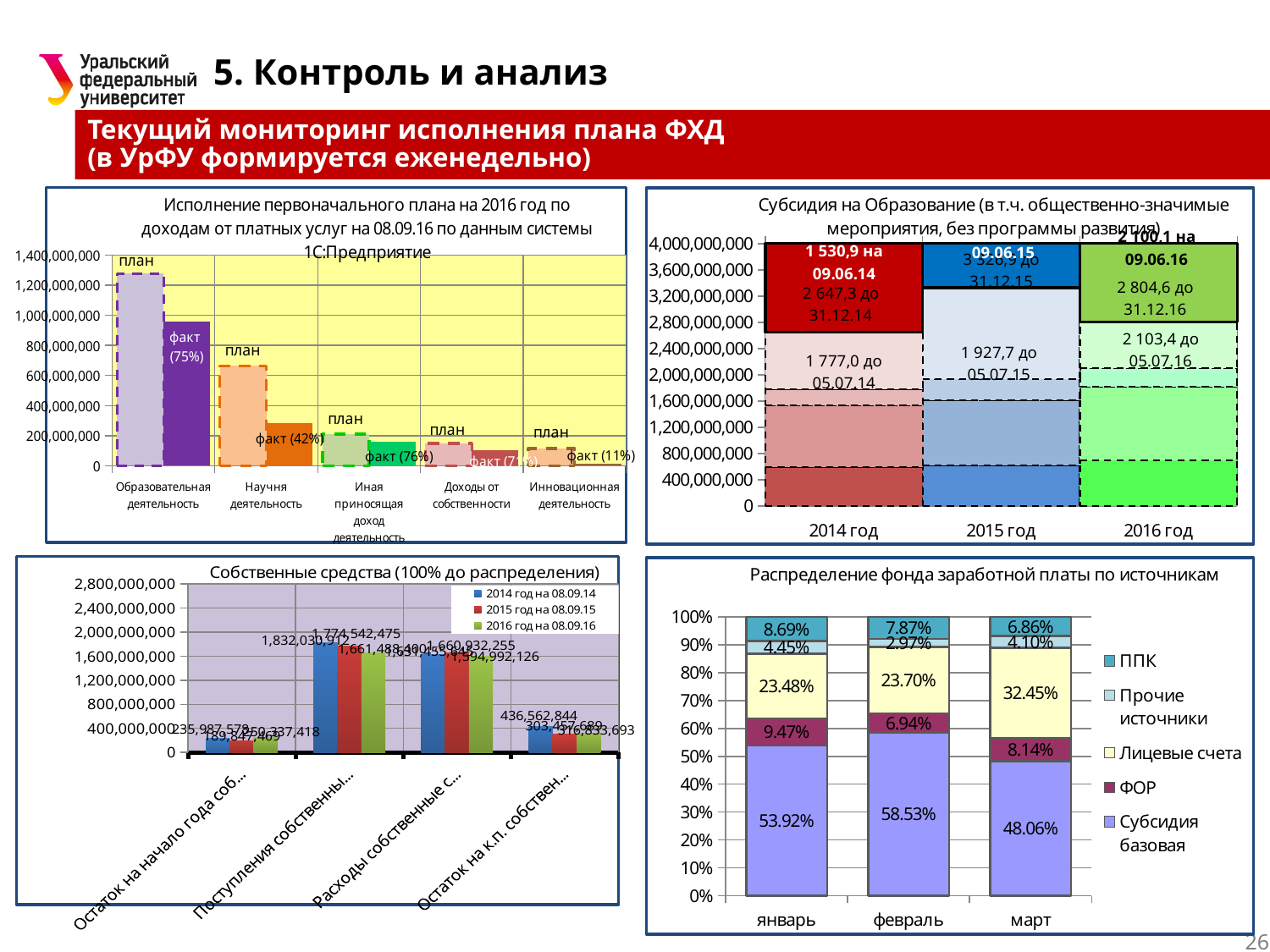
How many series does the legend of the chart 'Распределение фонда заработной платы по источникам' list? 5 How many year categories are shown on the x axis of the chart 'Субсидия на Образование'? 3 In the chart 'Распределение фонда заработной платы по источникам', what is the value for Лицевые счета in март? 32.45% In the top-left chart on plan execution for 2016, which category has the highest plan value? Образовательная деятельность In the top-left chart on plan execution for 2016, is the plan value for Образовательная деятельность greater or less than 1,200,000,000? greater In the top-left chart on plan execution for 2016, what is the fact percentage shown for Научная деятельность? 42% How many series does the legend of the chart 'Собственные средства (100% до распределения)' list? 3 In the chart 'Распределение фонда заработной платы по источникам', what is the value for ППК in январь? 8.69% In the chart 'Распределение фонда заработной платы по источникам', in which month is the share of Субсидия базовая the lowest? март In the chart 'Распределение фонда заработной платы по источникам', what is the difference between the ФОР share in январь and in февраль? 2.53% In the chart 'Распределение фонда заработной платы по источникам', which is larger: Прочие источники in январь or in март? январь In the chart 'Распределение фонда заработной платы по источникам', what is the value for Субсидия базовая in февраль? 58.53%